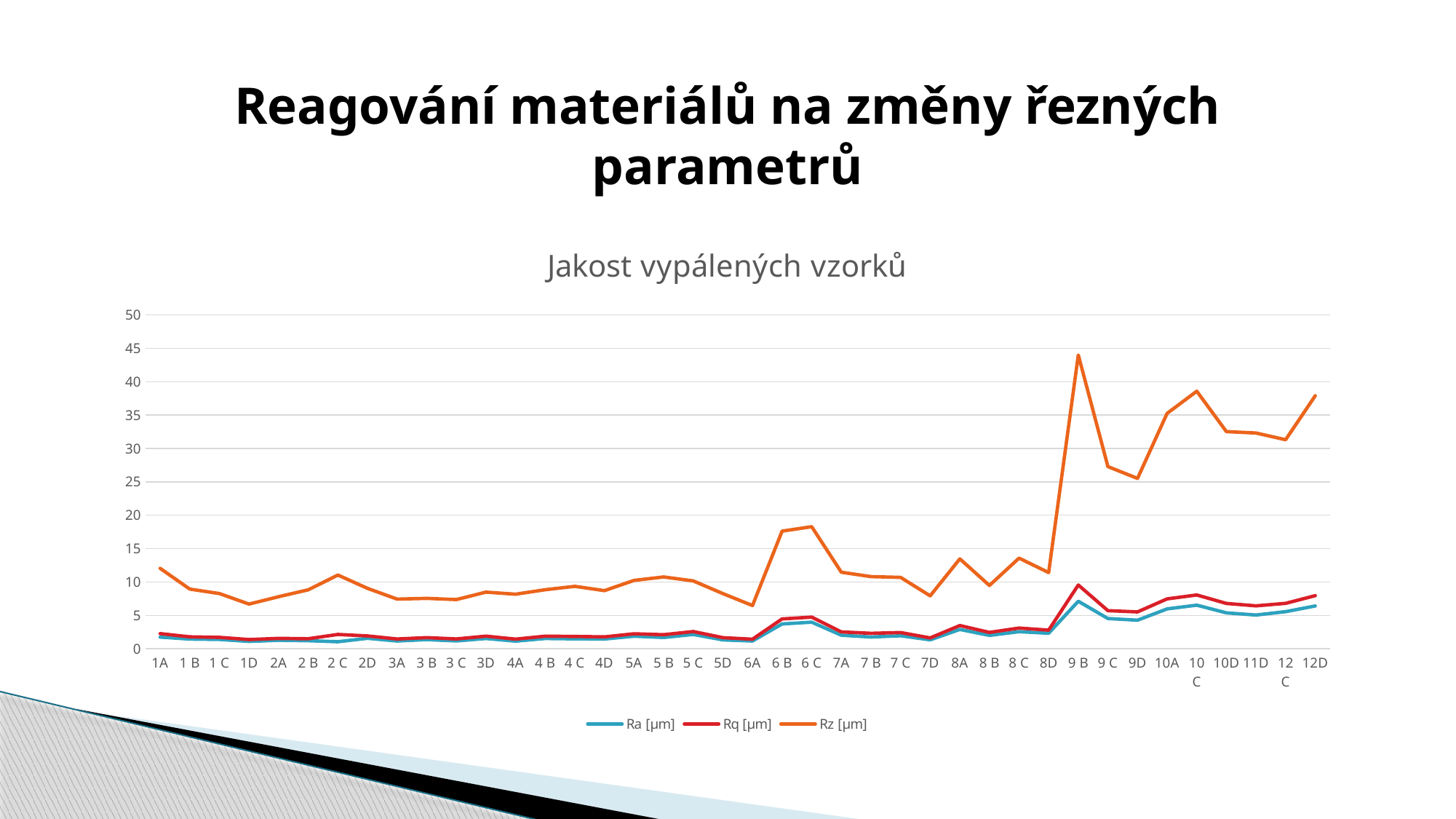
Which is larger for Rz [µm]: the value at 6B or the value at 7A? 6B What kind of chart is shown on the slide? line chart At which category does the Rz [µm] series reach its highest value? 9B How many series does the legend list? 3 Is the value of Rz [µm] at 9D greater or less than 30? less Is the value of Rz [µm] at 10C greater or less than 35? greater Which series is drawn in orange? Rz [µm] What is the title of the chart? Jakost vypálených vzorků Is the value of Rz [µm] at 9B greater or less than 40? greater Does the Rz [µm] series rise or fall between 8D and 9B? rise How many categories are shown on the x axis? 40